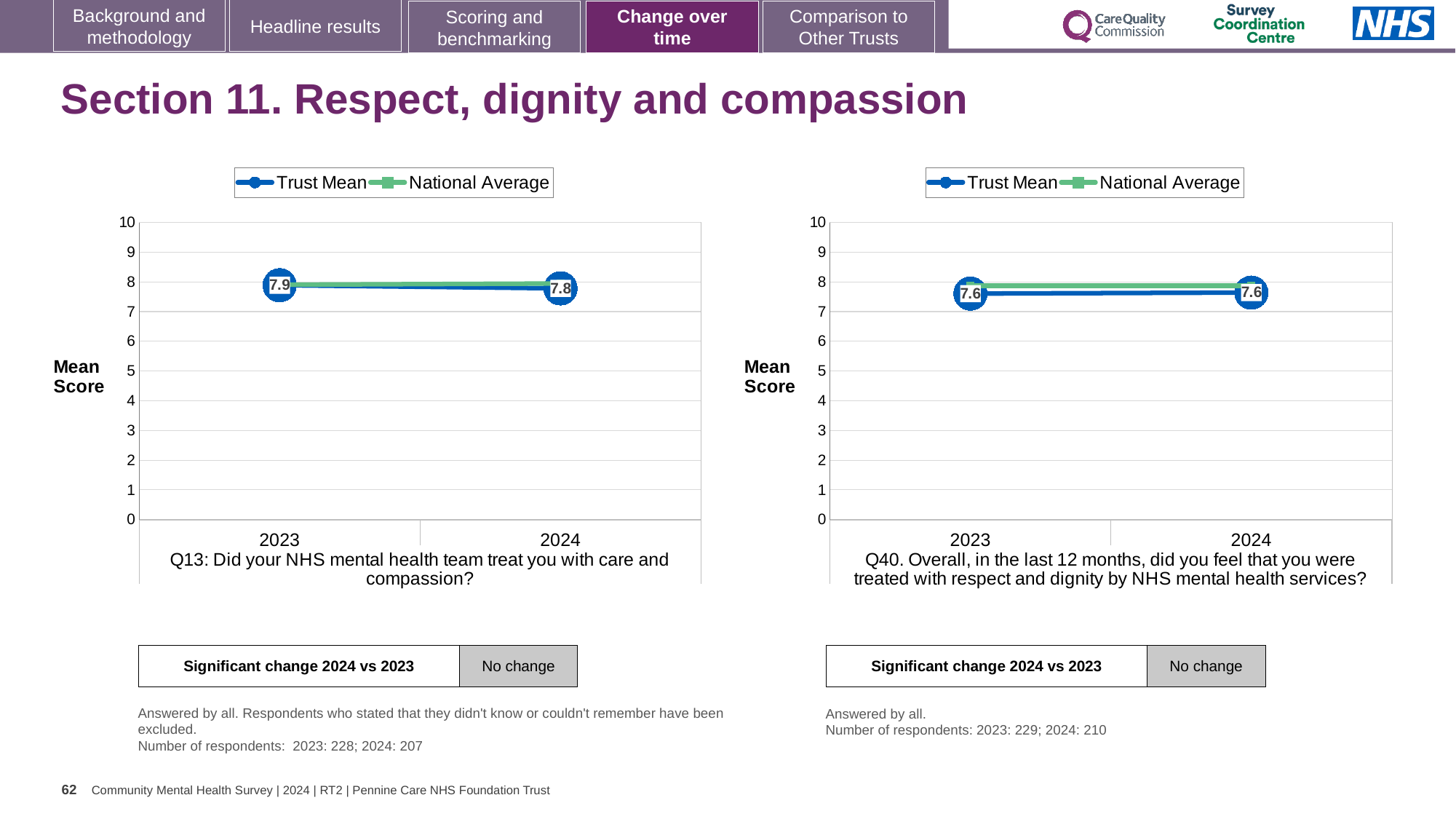
In the right chart (Q40), is the Trust Mean for 2023 greater or less than 8? less In the left chart (Q13), does the Trust Mean rise or fall from 2023 to 2024? fall In the right chart (Q40), what is the Trust Mean for 2023? 7.6 In the left chart (Q13), what is the Trust Mean for 2024? 7.8 How many years are plotted on the x axis of the right chart (Q40)? 2 What is the label of the y axis on the left chart (Q13)? Mean Score In the right chart (Q40), what is the Trust Mean for 2024? 7.6 In the left chart (Q13), what is the Trust Mean for 2023? 7.9 What kind of chart is the right chart (Q40)? line chart In the left chart (Q13), is the Trust Mean for 2023 greater or less than 7? greater In the left chart (Q13), what is the difference between the Trust Mean for 2023 and 2024? 0.1 How many series does the legend of the left chart (Q13) list? 2